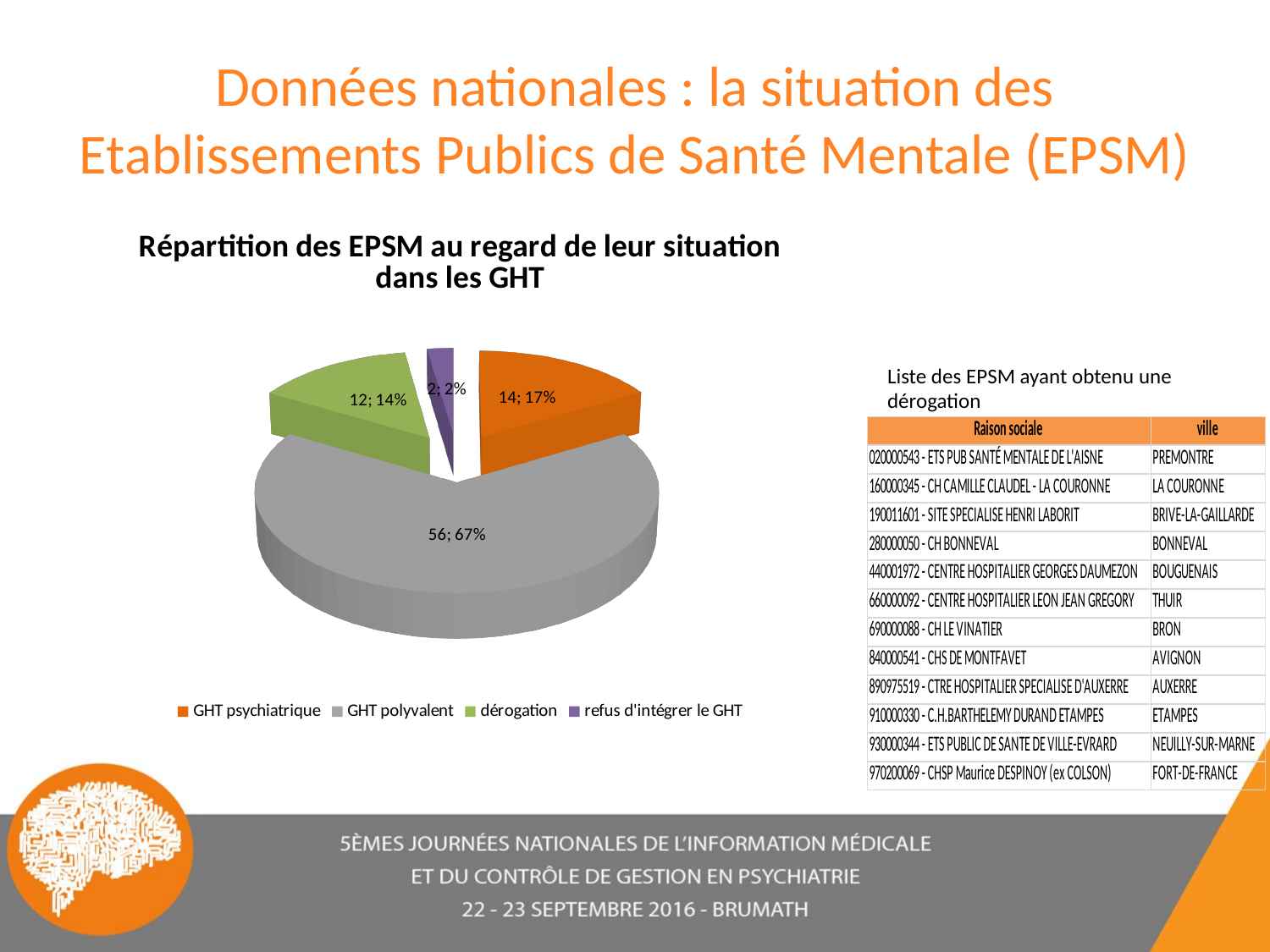
How many slices does the pie chart have? 4 What is the value shown for the GHT psychiatrique slice? 14; 17% What is the value shown for the dérogation slice? 12; 14% Which category has the smallest slice of the pie? refus d'intégrer le GHT What is the value shown for the refus d'intégrer le GHT slice? 2; 2% How many entries does the legend of the pie chart list? 4 What kind of chart is shown on the slide? pie chart What is the value shown for the GHT polyvalent slice? 56; 67% What is the difference in count between GHT polyvalent and GHT psychiatrique? 42 What share of the pie does the dérogation slice represent? 14% Which category has the largest slice of the pie? GHT polyvalent What is the title of the pie chart? Répartition des EPSM au regard de leur situation dans les GHT